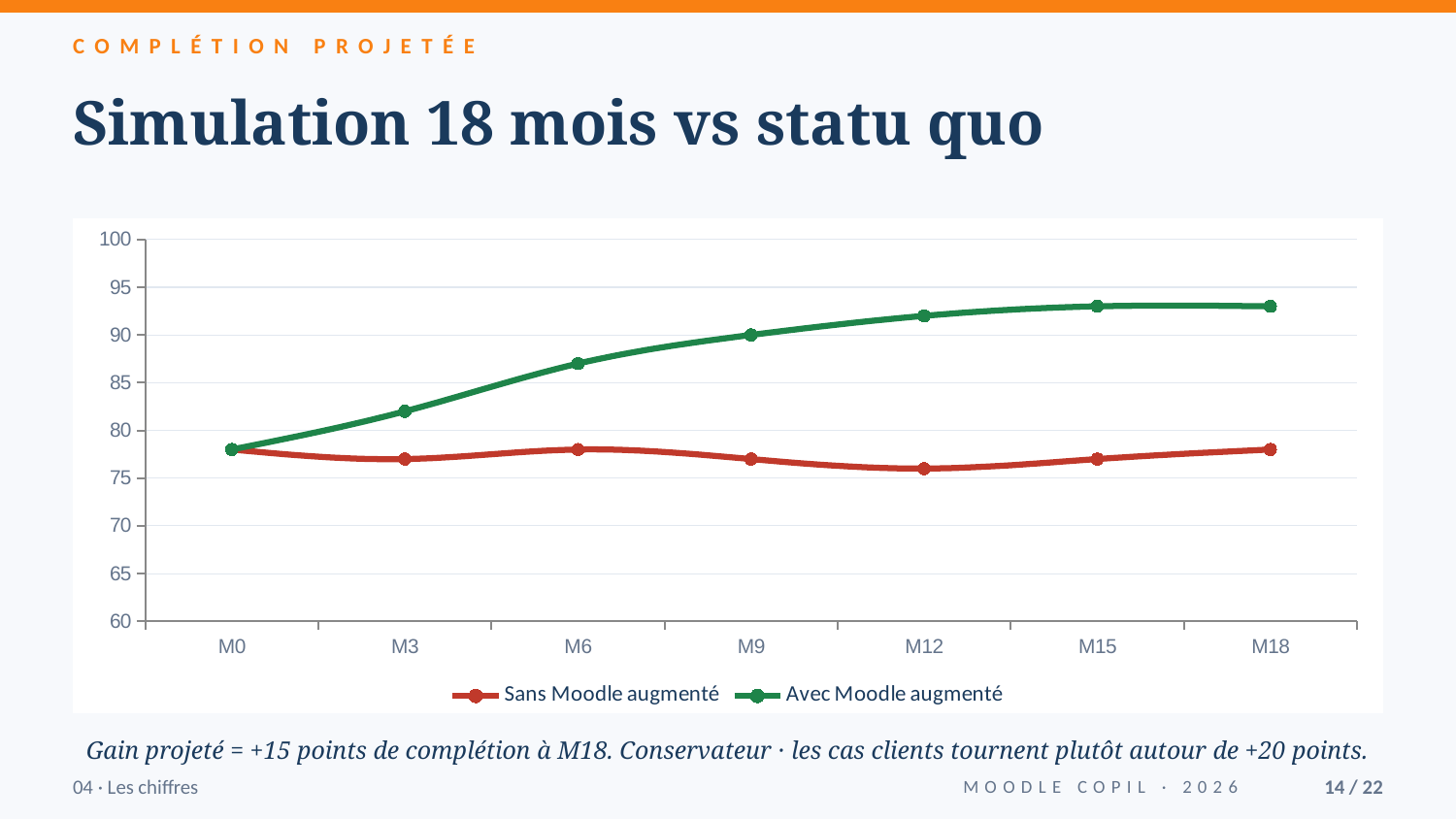
What are the two series names shown in the legend? Sans Moodle augmenté, Avec Moodle augmenté Is the value for 'Avec Moodle augmenté' at M6 greater or less than 85? greater How many points along the x axis does each series have? 7 For the 'Avec Moodle augmenté' series, at which x-axis point is the value lowest? M0 What is the title of the slide containing the chart? Simulation 18 mois vs statu quo Is the value for 'Avec Moodle augmenté' at M18 greater or less than 90? greater Does the 'Avec Moodle augmenté' series rise or fall from M0 to M18? rise Is the value for 'Avec Moodle augmenté' at M3 greater or less than 80? greater How many series does the legend list? 2 At M18, which series has the higher value? Avec Moodle augmenté What kind of chart is shown on the slide? line chart